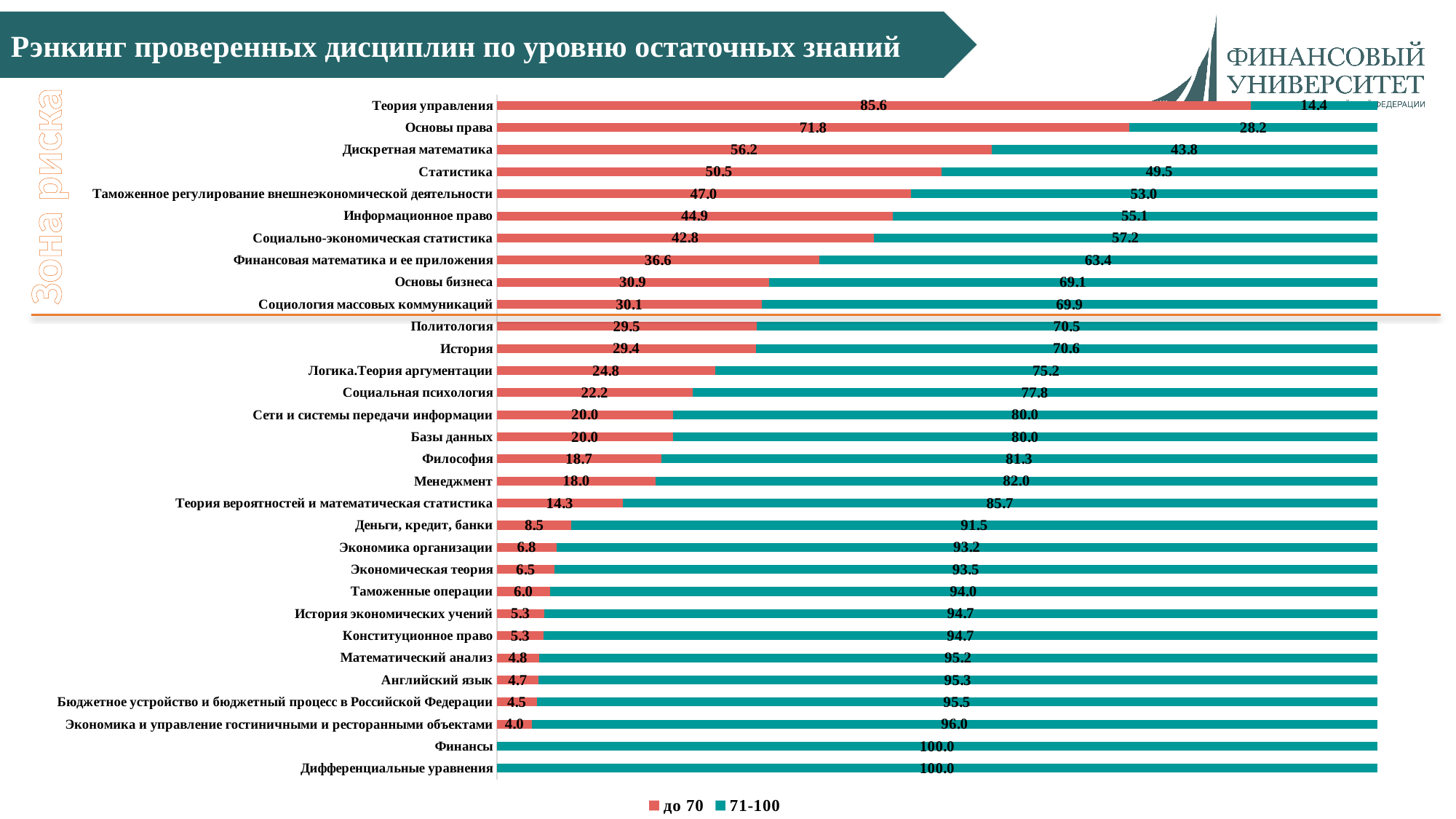
What is the value of the "до 70" series for Теория управления? 85.6 What are the two series names shown in the legend? до 70 and 71-100 What is the value of the "71-100" series for Статистика? 49.5 What is the value of the "до 70" series for Деньги, кредит, банки? 8.5 What kind of chart is shown on the slide? Stacked bar chart What is the difference between the "до 70" values for Основы права and Дискретная математика? 15.6 What is the total of the stacked bar for Информационное право? 100.0 Which discipline has the lowest value in the "71-100" series? Теория управления Which discipline has the highest value in the "до 70" series? Теория управления How many series does the legend list? 2 Which is larger: the "71-100" value for Философия or for Менеджмент? Менеджмент How many disciplines are listed on the chart? 31